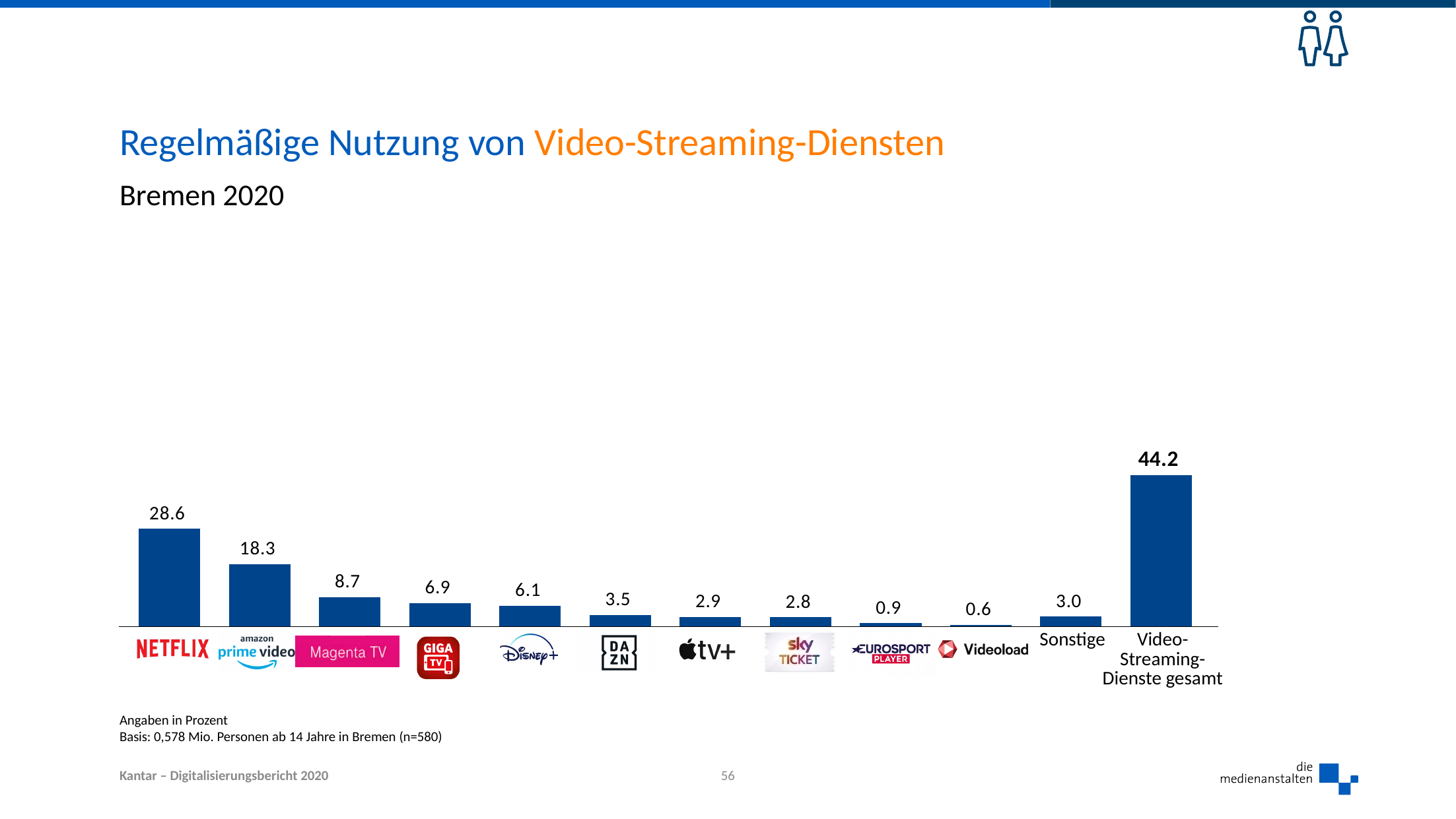
How many bars are shown in the chart? 12 What is the value for Video-Streaming-Dienste gesamt? 44.2 Which individual streaming service has the highest value? Netflix Which is larger, the value for Magenta TV or the value for GIGA TV? Magenta TV What is the value for Netflix? 28.6 In what unit are the values given, according to the note below the chart? Prozent What is the value for Disney+? 6.1 Which category has the lowest value? Videoload What kind of chart is shown on the slide? Bar chart What is the difference between the values for Netflix and Amazon Prime Video? 10.3 What is the value for Sonstige? 3.0 What is the value for Amazon Prime Video? 18.3